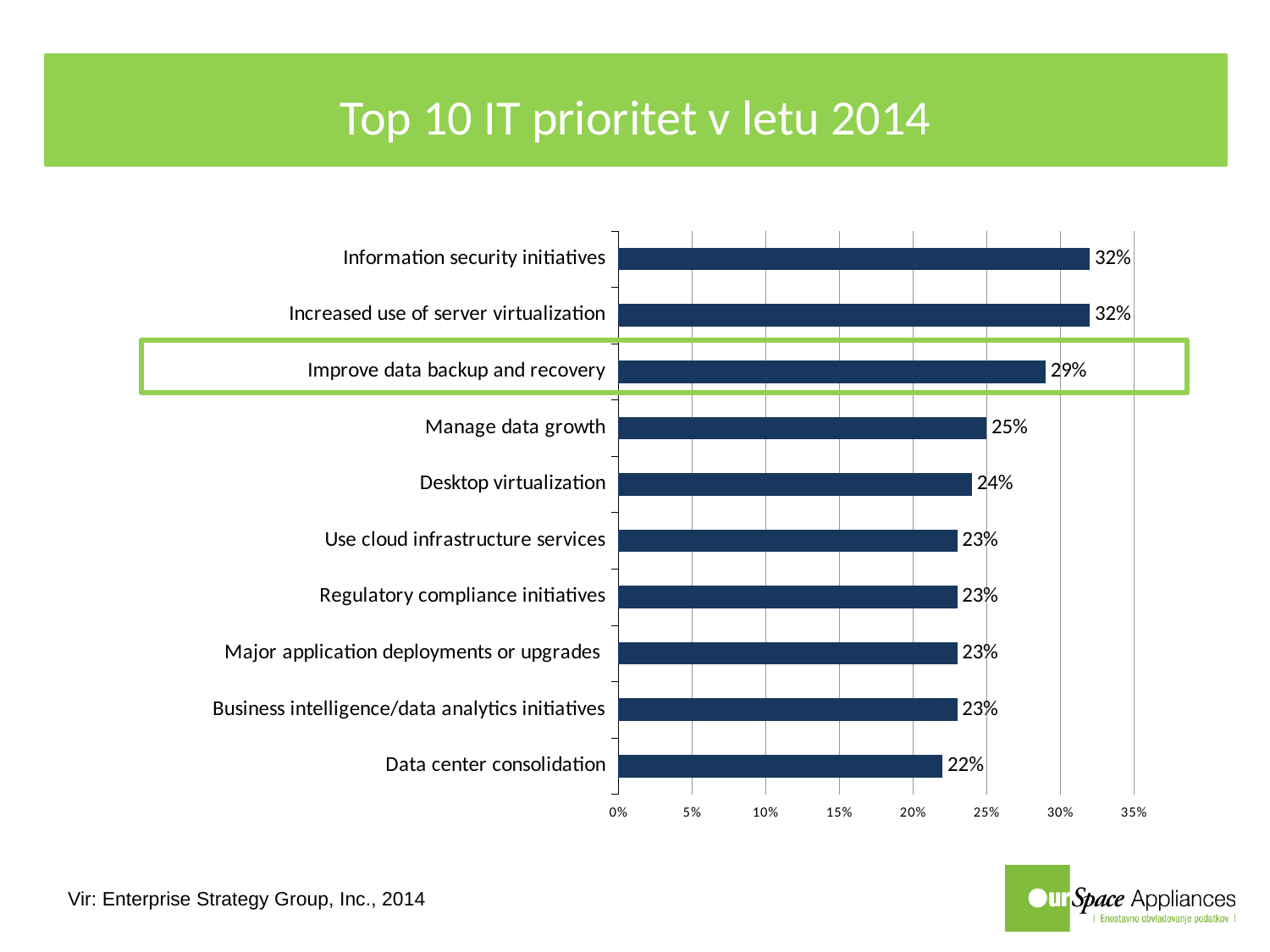
What is the difference between Information security initiatives and Improve data backup and recovery? 3% What kind of chart is shown on the slide? bar chart What is the difference between Manage data growth and Data center consolidation? 3% What is the value for Manage data growth? 25% How many categories are shown in the chart? 10 What is the value for Improve data backup and recovery? 29% Is the value for Improve data backup and recovery greater or less than 25%? greater Which is larger, Manage data growth or Desktop virtualization? Manage data growth Which category has the lowest value? Data center consolidation What is the title of the slide? Top 10 IT prioritet v letu 2014 What is the value for Desktop virtualization? 24% What is the value for Data center consolidation? 22%